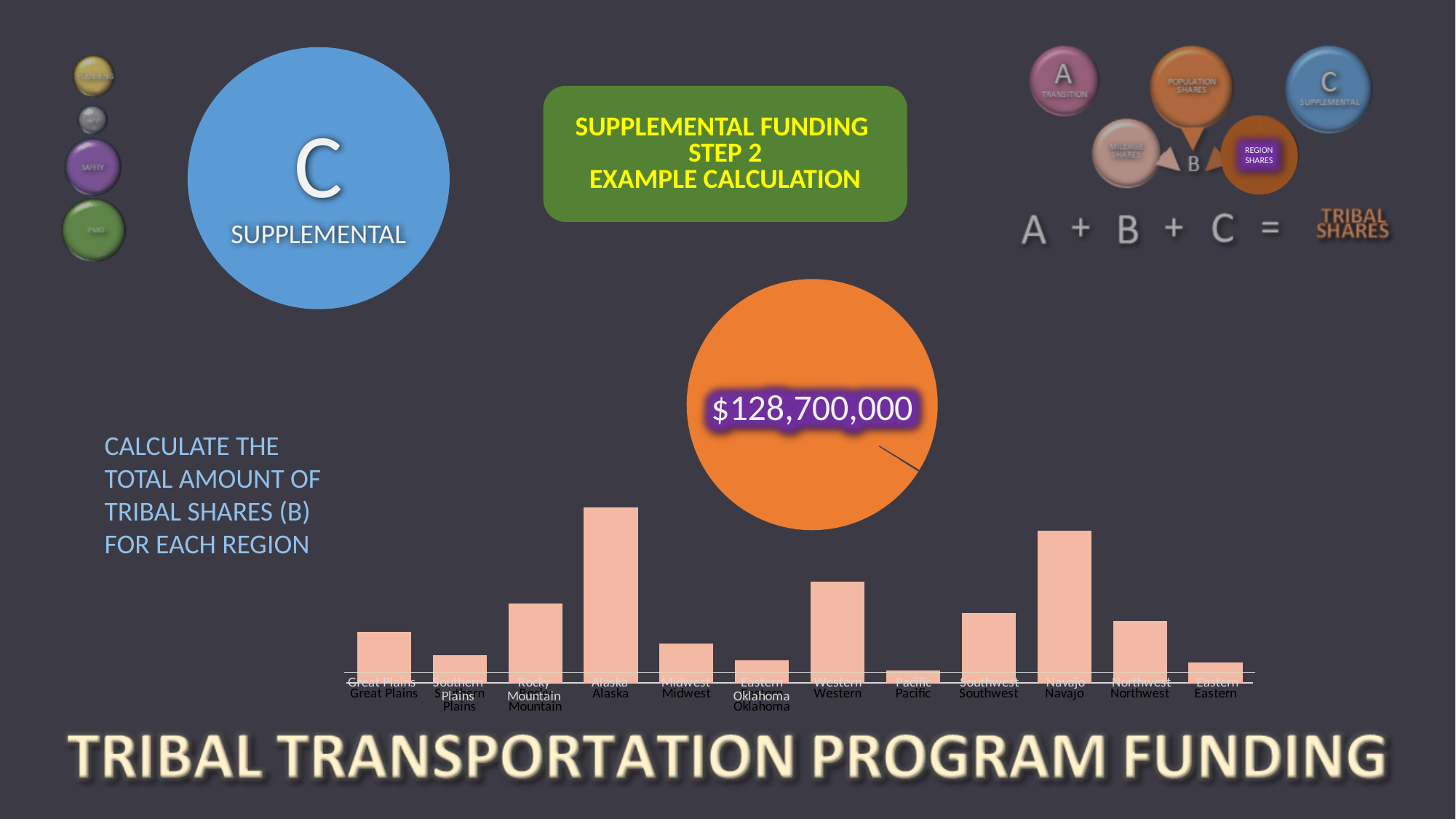
Which region is the first category on the left of the bar chart? Great Plains Which region has the shortest bar in the chart? Pacific Which bar is taller, Navajo or Western? Navajo Which bar is taller, Midwest or Rocky Mountain? Rocky Mountain Which bar is taller, Southern Plains or Southwest? Southwest Which region has the second tallest bar in the chart? Navajo What kind of chart is shown at the bottom of the slide? bar chart How many regions are shown as categories in the bar chart? 12 Which region is the last category on the right of the bar chart? Eastern Which region has the tallest bar in the chart? Alaska